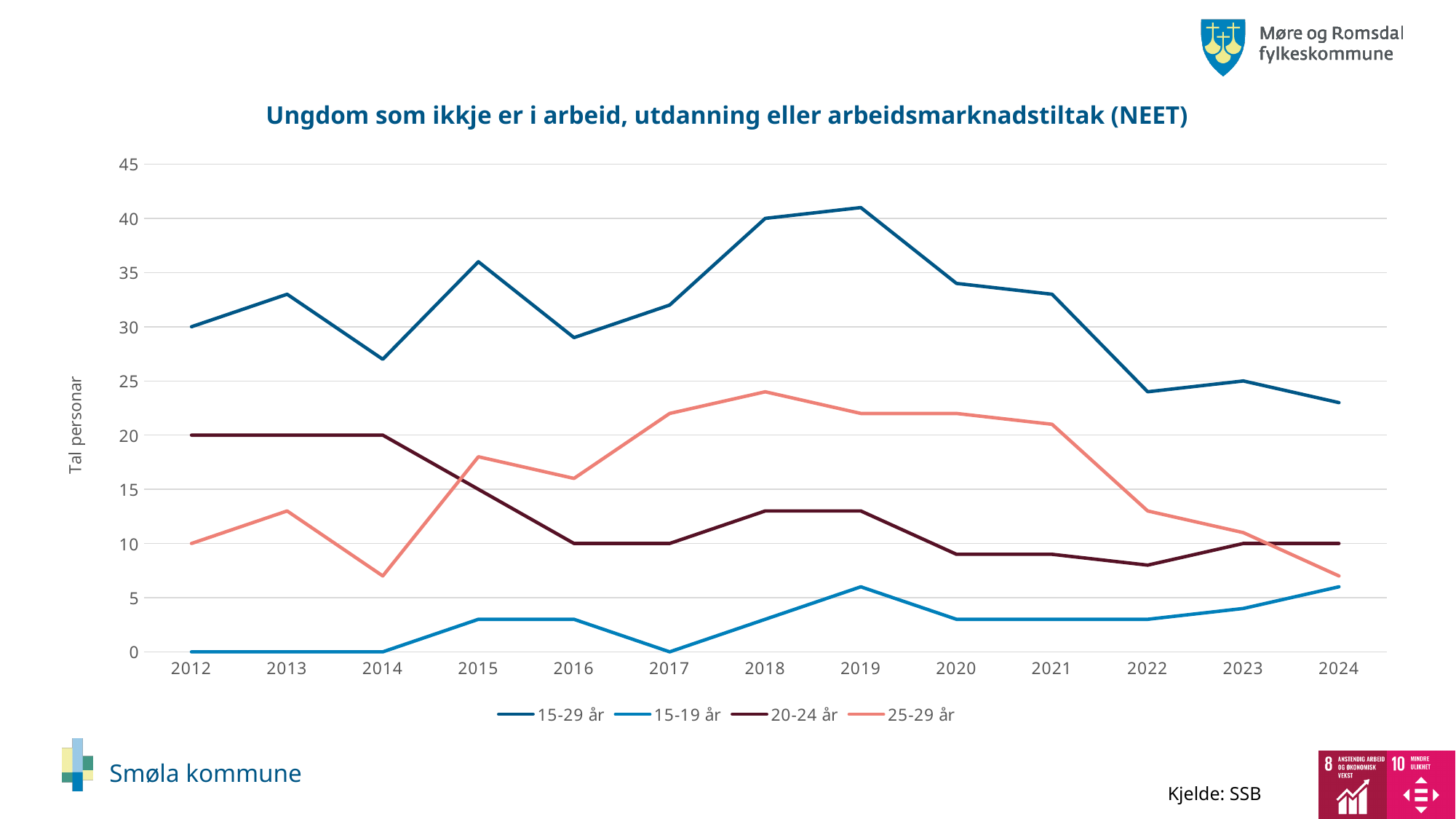
What is the value for 15-29 år in 2012? 30 What kind of chart is shown on the slide? line chart What is the title of the chart? Ungdom som ikkje er i arbeid, utdanning eller arbeidsmarknadstiltak (NEET) How many series does the legend list? 4 In which year does the 25-29 år series reach its lowest value? 2014 and 2024 How many years are shown on the x axis? 13 Which series has the larger value in 2021, 20-24 år or 25-29 år? 25-29 år What is the value for 15-19 år in 2017? 0 What is the value for 15-29 år in 2018? 40 What is the value for 20-24 år in 2013? 20 Is the value for 15-29 år in 2022 greater or less than 25? less In which year does the 15-29 år series reach its highest value? 2019